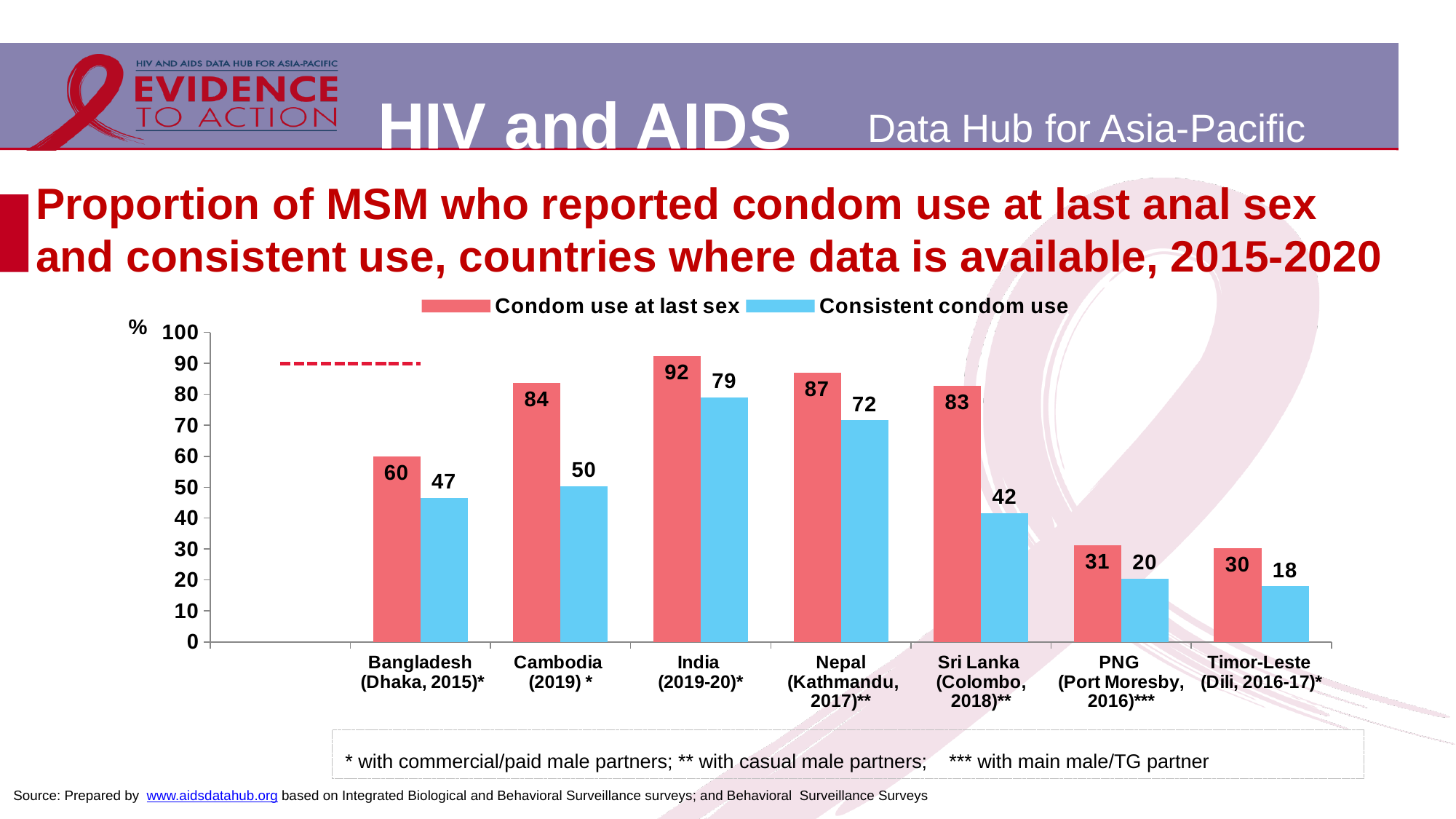
What kind of chart is shown on the slide? Bar chart Which country has the highest value for Condom use at last sex? India (2019-20)* What is the difference between Condom use at last sex in Cambodia (2019)* and in Nepal (Kathmandu, 2017)**? 3 How many series does the legend list? 2 What is the value for Condom use at last sex in India (2019-20)*? 92 What is the value for Consistent condom use in Bangladesh (Dhaka, 2015)*? 47 What is the difference between Condom use at last sex and Consistent condom use in Sri Lanka (Colombo, 2018)**? 41 Which colour represents Consistent condom use in the chart? Blue Which is larger: Consistent condom use in Cambodia (2019)* or in Nepal (Kathmandu, 2017)**? Nepal (Kathmandu, 2017)** How many countries are shown on the x axis? 7 Which country has the lowest value for Consistent condom use? Timor-Leste (Dili, 2016-17)* What is the value for Consistent condom use in Sri Lanka (Colombo, 2018)**? 42